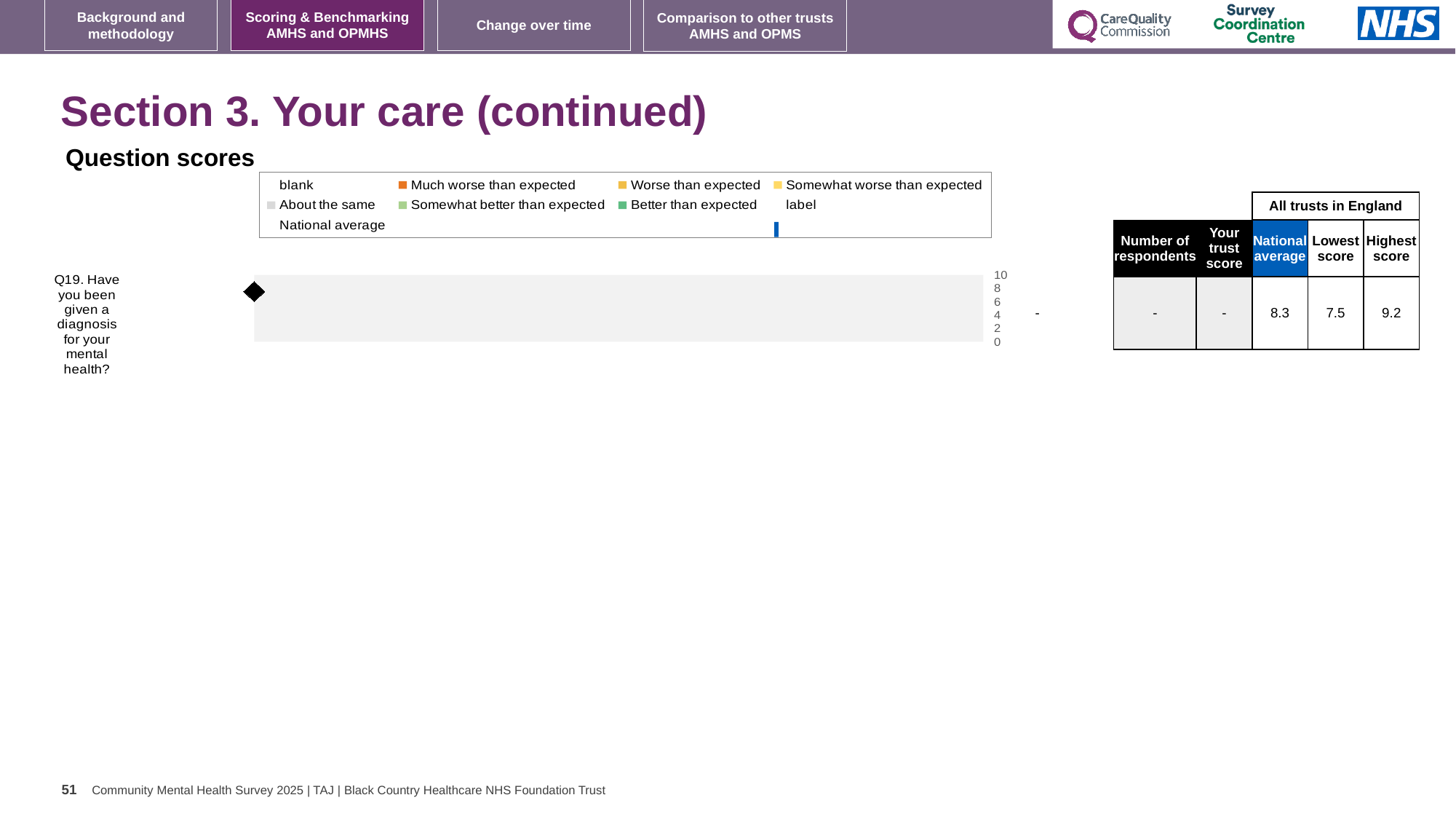
What data label is shown for the trust score of Q19 in the chart? - In the table next to the chart, what is the Highest score for Q19? 9.2 In the table next to the chart, what is shown for the Number of respondents for Q19? - In the table next to the chart, what is the National average for Q19? 8.3 How many questions (categories) are plotted in the Question scores chart? 1 What is the highest value shown on the chart's axis? 10 In the table next to the chart, what is the Lowest score for Q19? 7.5 In the table next to the chart, what is the difference between the Highest score and the Lowest score for Q19? 1.7 What kind of chart is shown under 'Question scores'? bar chart In the table next to the chart, which is larger for Q19: the National average or the Lowest score? National average Which question is plotted in the Question scores chart? Q19. Have you been given a diagnosis for your mental health?